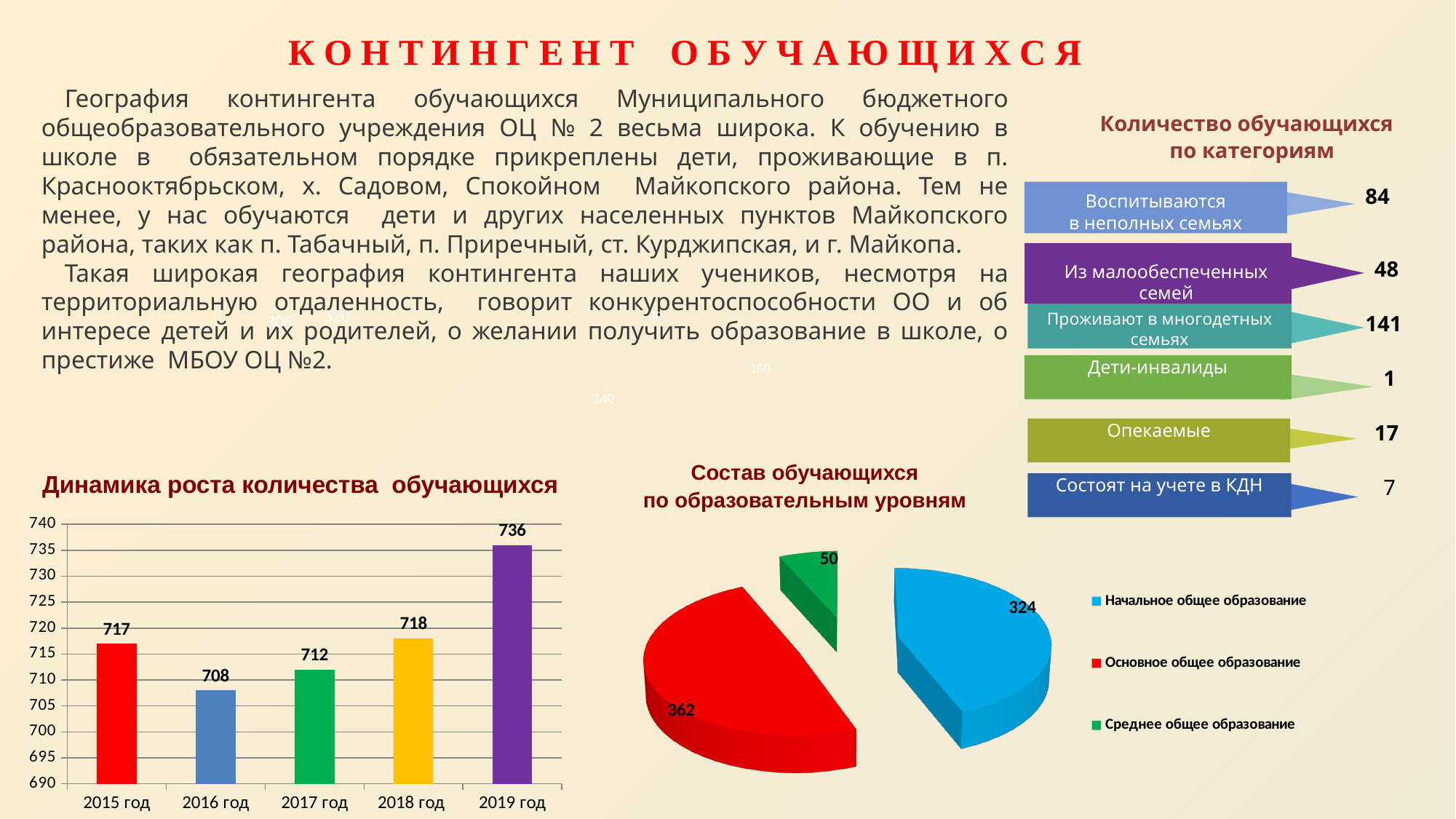
In the chart 'Динамика роста количества обучающихся', what is the value for 2016 год? 708 In the pie chart 'Состав обучающихся по образовательным уровням', which category has the smallest slice? Среднее общее образование In the chart 'Динамика роста количества обучающихся', what is the difference between the values for 2019 год and 2015 год? 19 In the chart 'Динамика роста количества обучающихся', do the values rise or fall from 2016 год to 2019 год? rise How many entries does the legend of the pie chart 'Состав обучающихся по образовательным уровням' list? 3 How many years are shown in the chart 'Динамика роста количества обучающихся'? 5 In the pie chart 'Состав обучающихся по образовательным уровням', what is the value for Основное общее образование? 362 What kind of chart is 'Динамика роста количества обучающихся'? bar chart In the chart 'Динамика роста количества обучающихся', which year has the lowest value? 2016 год In the chart 'Динамика роста количества обучающихся', what is the value for 2019 год? 736 In the chart 'Динамика роста количества обучающихся', which is larger: the value for 2017 год or 2018 год? 2018 год In the chart 'Динамика роста количества обучающихся', which year has the highest value? 2019 год